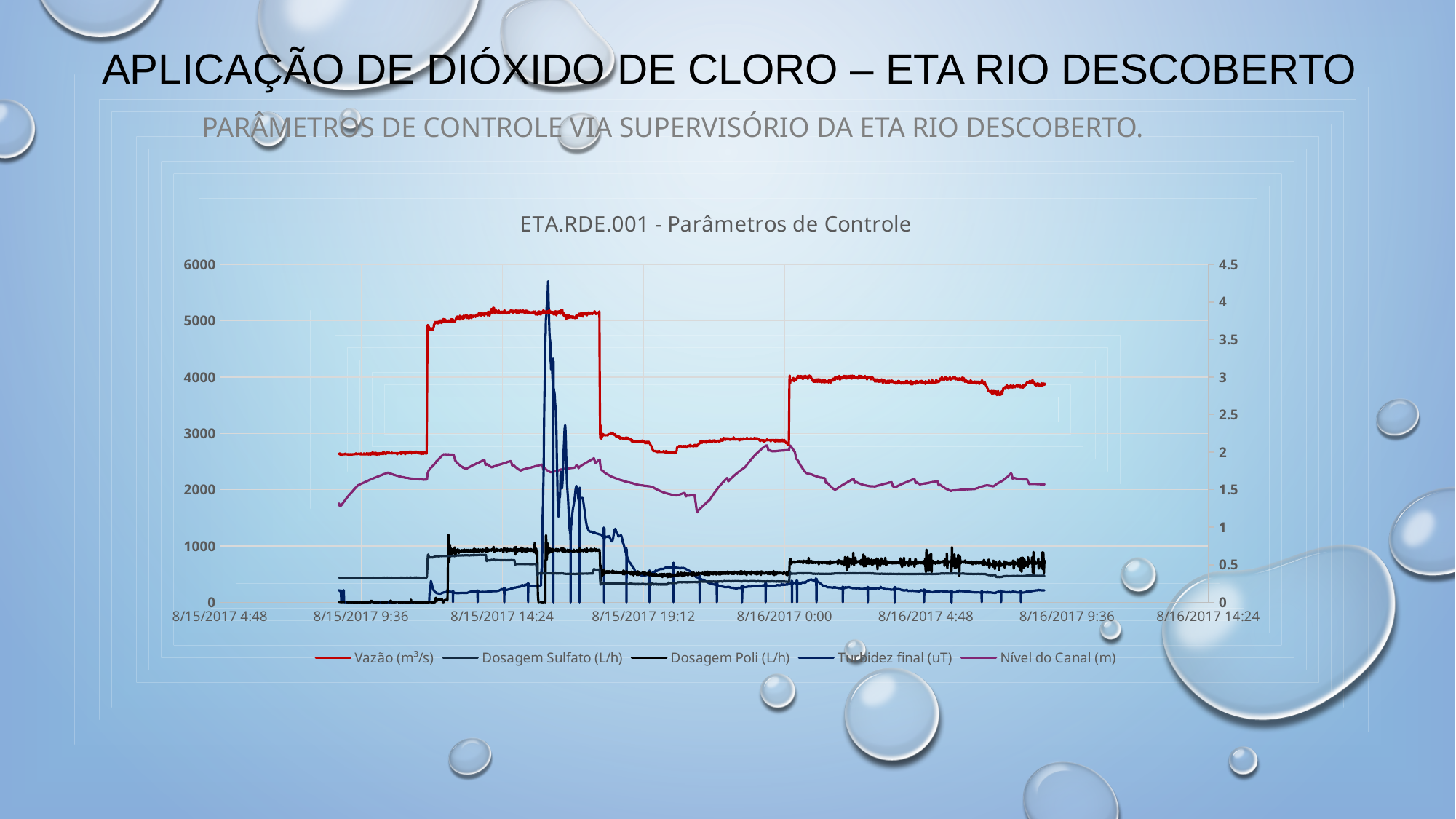
Does the purple Nível do Canal line rise or fall between 8/16/2017 0:00 and 8/16/2017 4:48? fall At 8/16/2017 4:48, is the red Vazão line above or below the gridline labelled 3000 on the left axis? above Which colour is used for the Vazão (m³/s) series in the chart? red At 8/15/2017 14:24, is the red Vazão line above or below the gridline labelled 5000 on the left axis? above How many series does the legend of the chart list? 5 Does the red Vazão line rise or fall between 8/15/2017 14:24 and 8/15/2017 19:12? fall At 8/15/2017 9:36, is the red Vazão line above or below the gridline labelled 3000 on the left axis? below What is the title of the chart? ETA.RDE.001 - Parâmetros de Controle How many date-time labels are shown along the x axis of the chart? 8 What kind of chart is shown on the slide? line chart Does the red Vazão line rise or fall between 8/15/2017 9:36 and 8/15/2017 14:24? rise